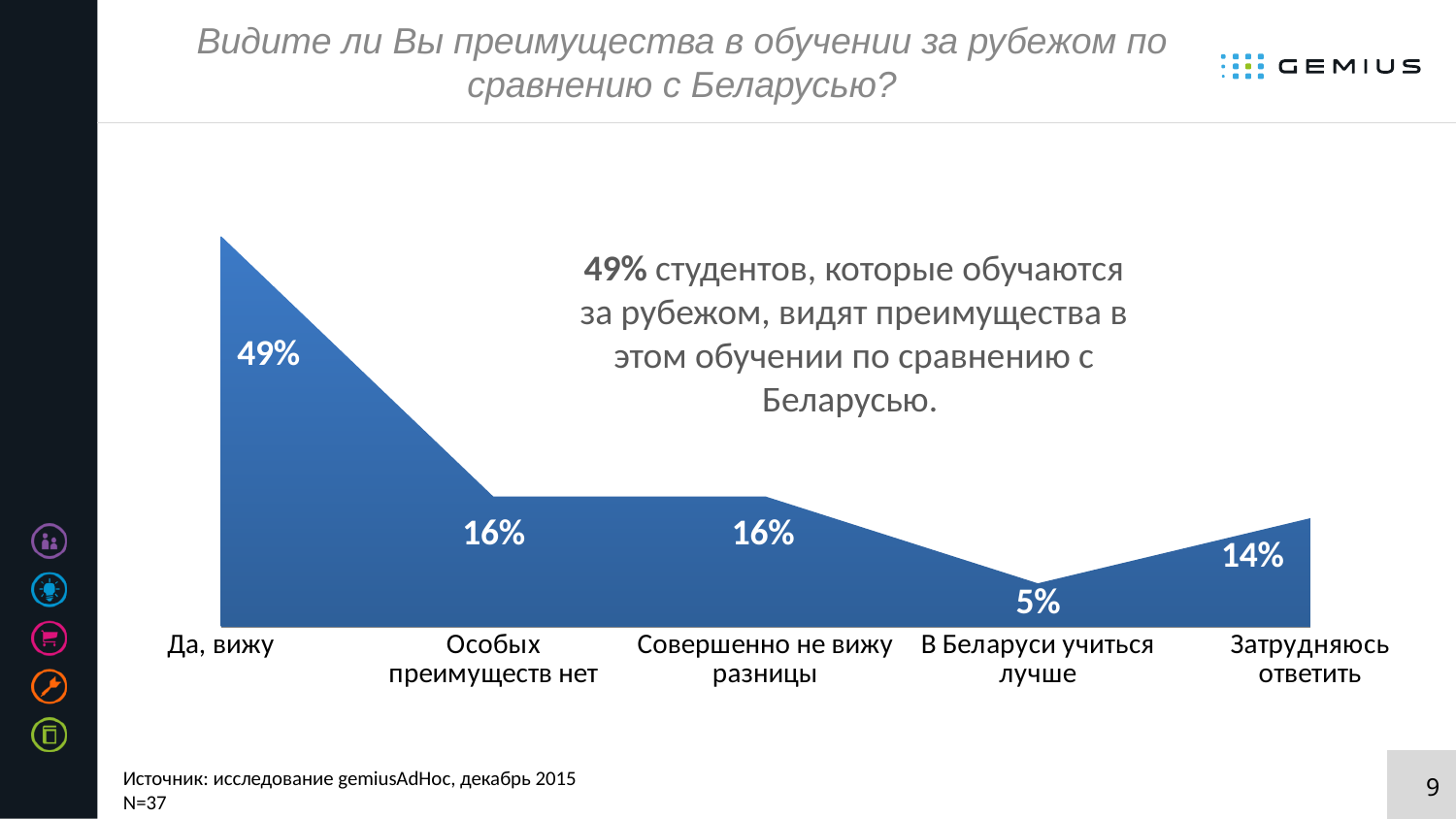
How many categories are shown on the x axis? 5 What is the difference between the values for "Совершенно не вижу разницы" and "В Беларуси учиться лучше"? 11% Which is larger: the value for "Затрудняюсь ответить" or the value for "В Беларуси учиться лучше"? Затрудняюсь ответить What is the value for "Да, вижу"? 49% What is the difference between the values for "Да, вижу" and "Затрудняюсь ответить"? 35% Which category has the highest value? Да, вижу What is the sample size (N) stated on the slide? N=37 What kind of chart is shown on the slide? Area chart What is the value for "Особых преимуществ нет"? 16% What is the value for "Затрудняюсь ответить"? 14% Which category has the lowest value? В Беларуси учиться лучше What is the value for "В Беларуси учиться лучше"? 5%